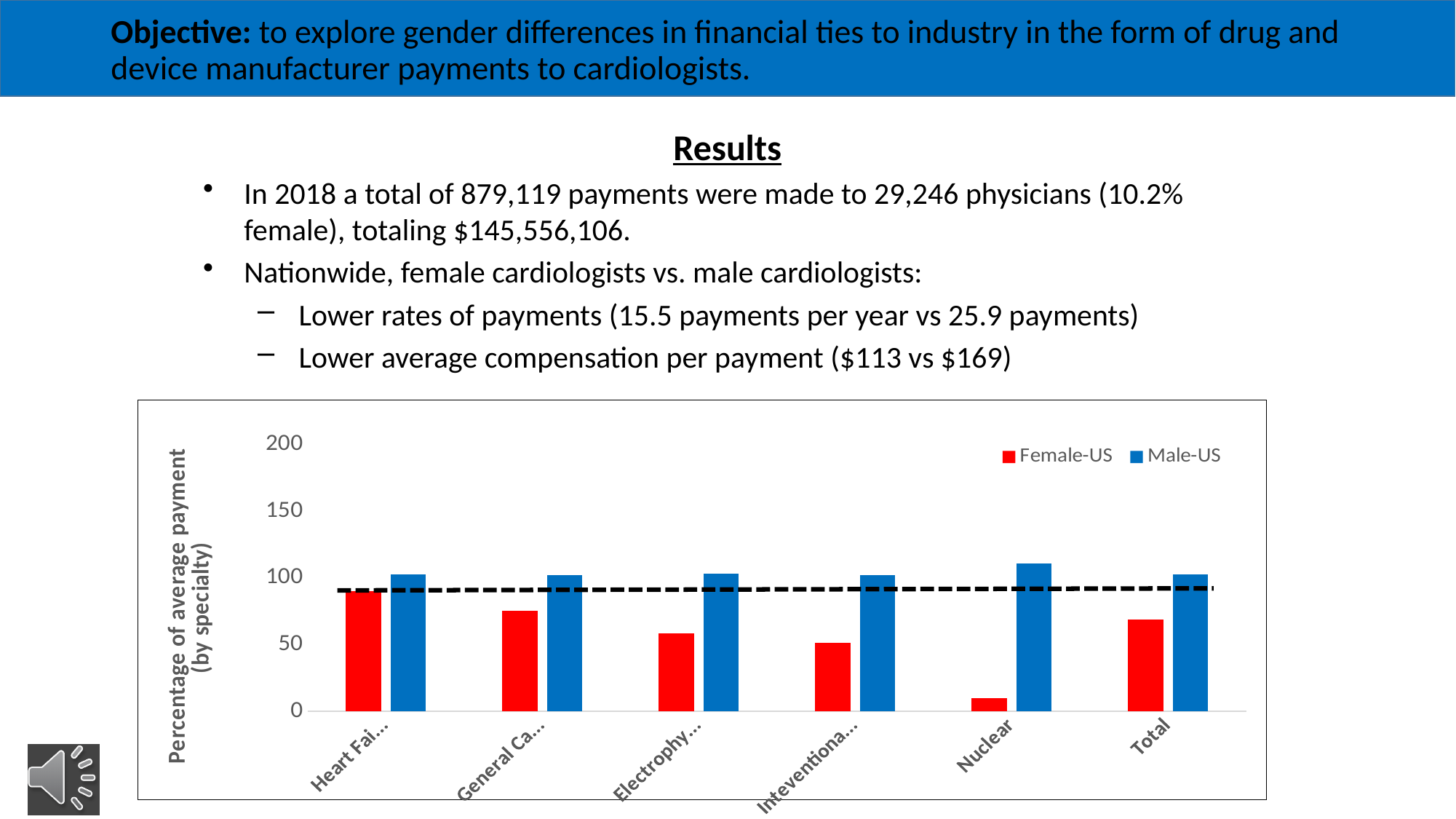
What colour are the Female-US bars in the chart? red Which category has the lowest Female-US value? Nuclear Is the Female-US value for Nuclear greater or less than 50? less How many series does the chart legend list? 2 Is the Female-US value for Total greater or less than 50? greater How many categories are shown along the x axis of the chart? 6 Which category has the highest Male-US value? Nuclear What kind of chart is shown on the slide? bar chart Is the Female-US value for Total greater or less than 100? less For the Nuclear category, which series has the larger value, Female-US or Male-US? Male-US For the Total category, which series has the larger value, Female-US or Male-US? Male-US